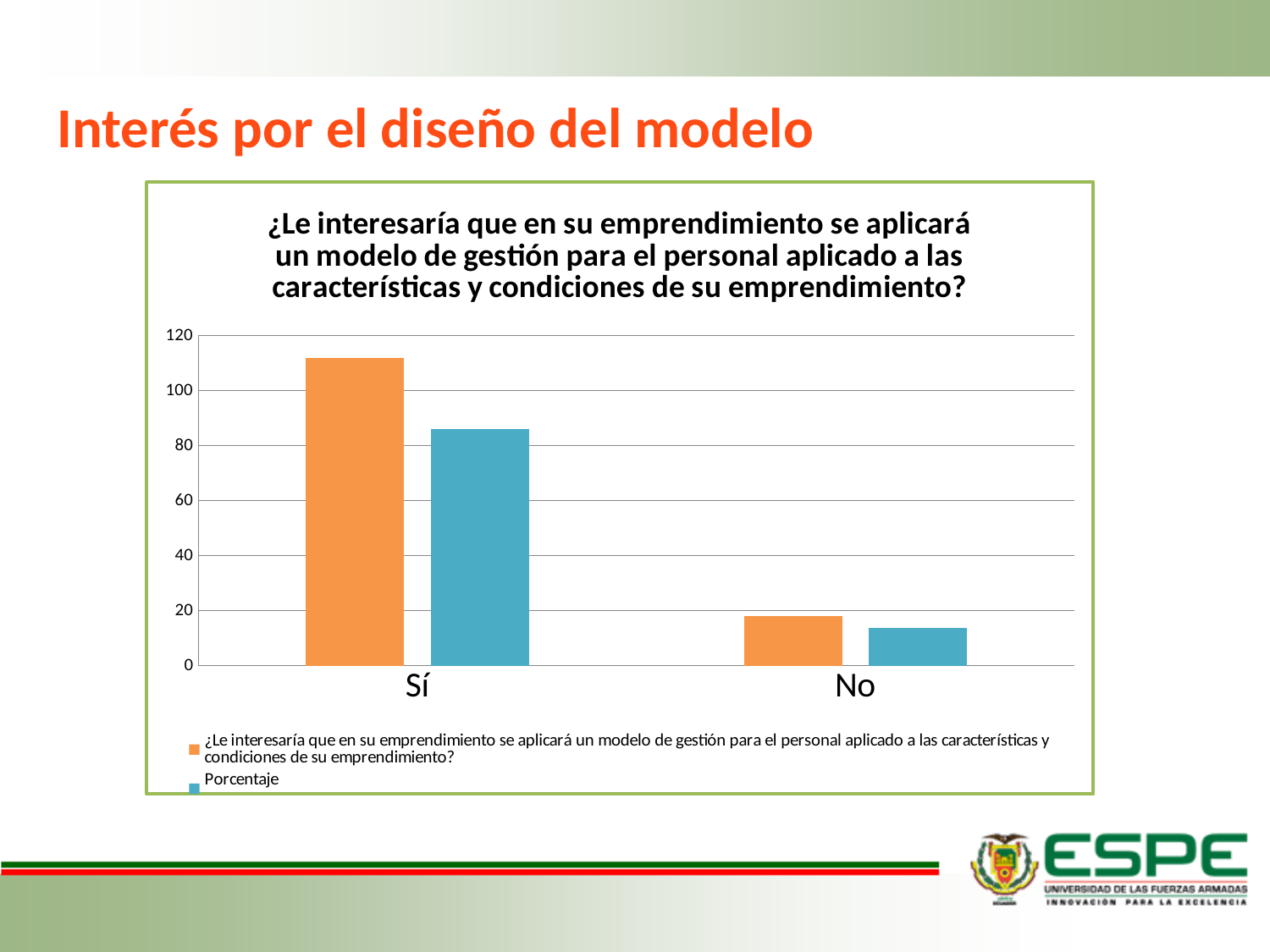
How many series does the chart's legend list? 2 Is the orange bar for Sí greater or less than 100? greater Is the Porcentaje bar for Sí greater or less than 100? less Is the orange bar for No greater or less than 40? less For the category Sí, which bar is taller, the orange one or the blue Porcentaje one? the orange one What is the label of the second series in the chart's legend? Porcentaje How many categories are shown on the x axis of the chart? 2 Which is larger, the Porcentaje value for Sí or the Porcentaje value for No? Sí Which category has the lowest bars in the chart? No What kind of chart is shown on the slide? bar chart Which category has the highest bars in the chart? Sí